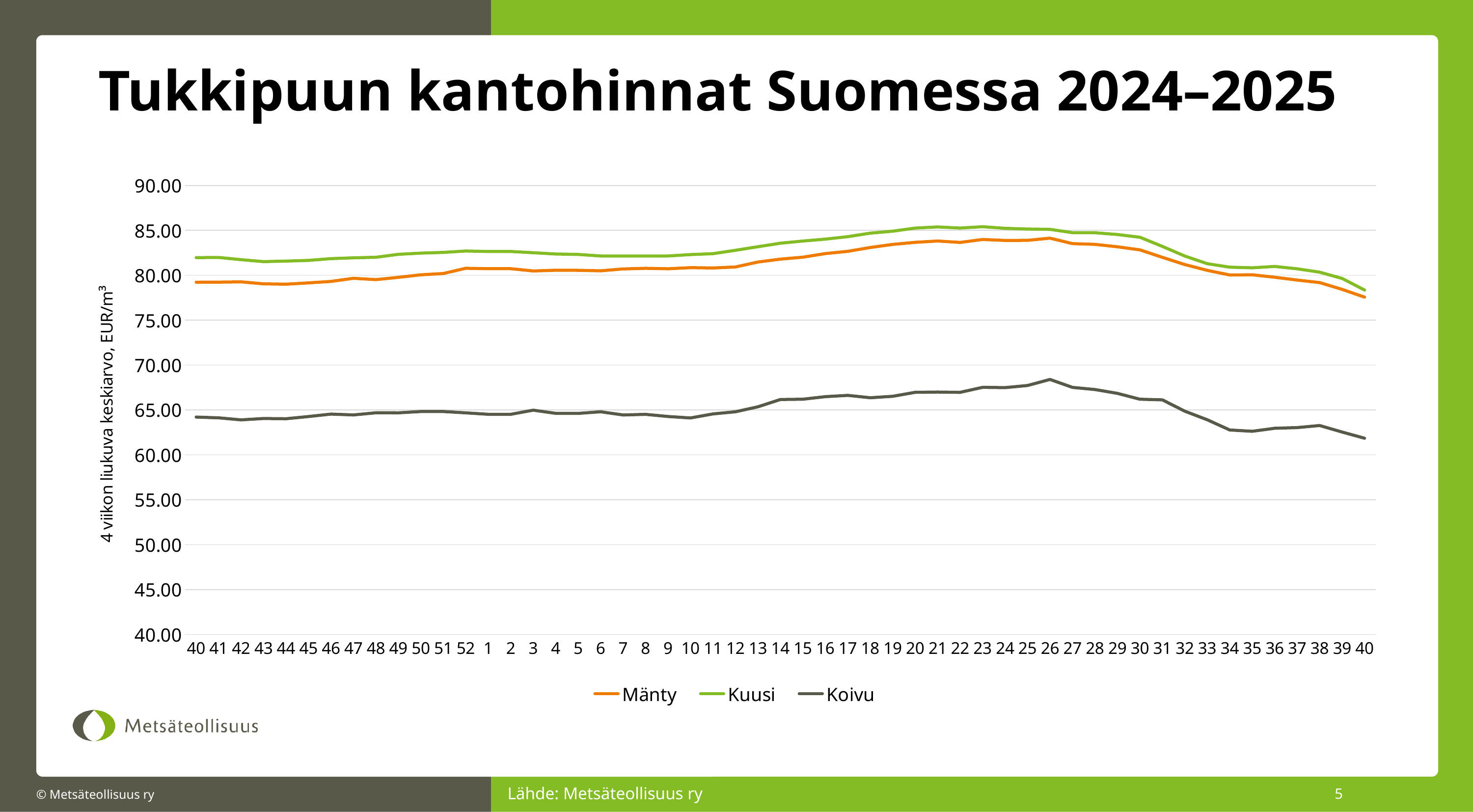
What is the title of the chart? Tukkipuun kantohinnat Suomessa 2024–2025 At week 20, which is larger, the value for Kuusi or the value for Mänty? Kuusi How many week labels are shown on the x axis? 53 Do the Koivu values rise or fall from week 30 to week 40 at the right end of the chart? fall Is the value for Kuusi at the first week 40 greater or less than 80.00? greater Is the value for Koivu at week 34 greater or less than 65.00? less Is the value for Mänty at the last week 40 greater or less than 80.00? less Which series has the highest values throughout the chart? Kuusi Which series has the lowest values throughout the chart? Koivu What kind of chart is shown on the slide? line chart How many series does the legend list? 3